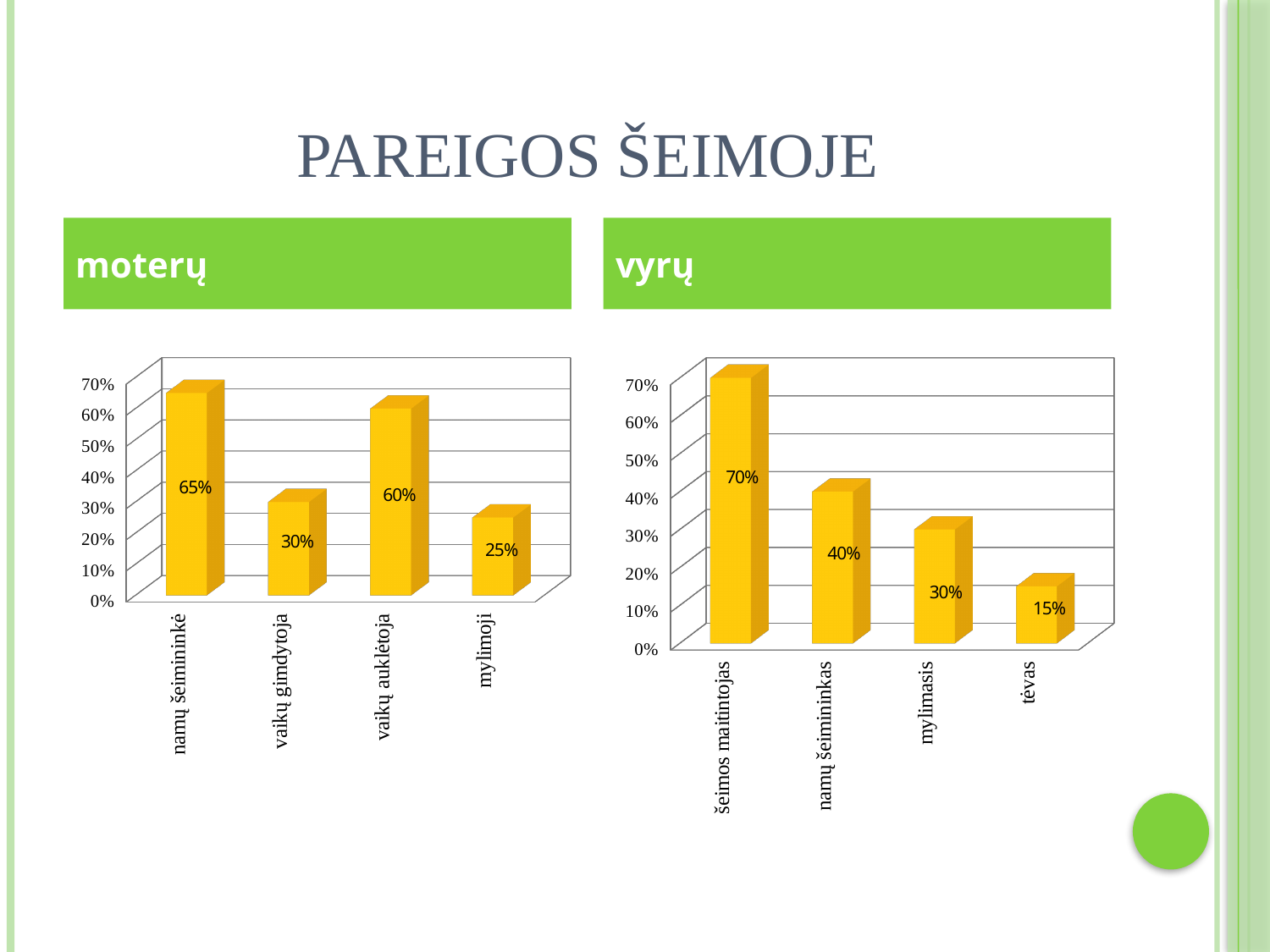
In the 'moterų' chart, which is larger: 'vaikų auklėtoja' or 'mylimoji'? vaikų auklėtoja In the 'vyrų' chart, what is the difference between 'šeimos maitintojas' and 'namų šeimininkas'? 30% In the 'vyrų' chart, what is the value for 'tėvas'? 15% In the 'vyrų' chart, is the value for 'mylimasis' greater or less than 20%? greater How many categories are shown in the 'moterų' chart? 4 What kind of chart is the 'vyrų' chart? bar chart In the 'moterų' chart, what is the difference between 'namų šeimininkė' and 'vaikų gimdytoja'? 35% In the 'vyrų' chart, which category has the highest value? šeimos maitintojas In the 'moterų' chart, what is the value for 'namų šeimininkė'? 65% In the 'moterų' chart, which category has the lowest value? mylimoji In the 'vyrų' chart, do the values rise or fall from left to right along the x axis? fall What is the title of the slide? PAREIGOS ŠEIMOJE